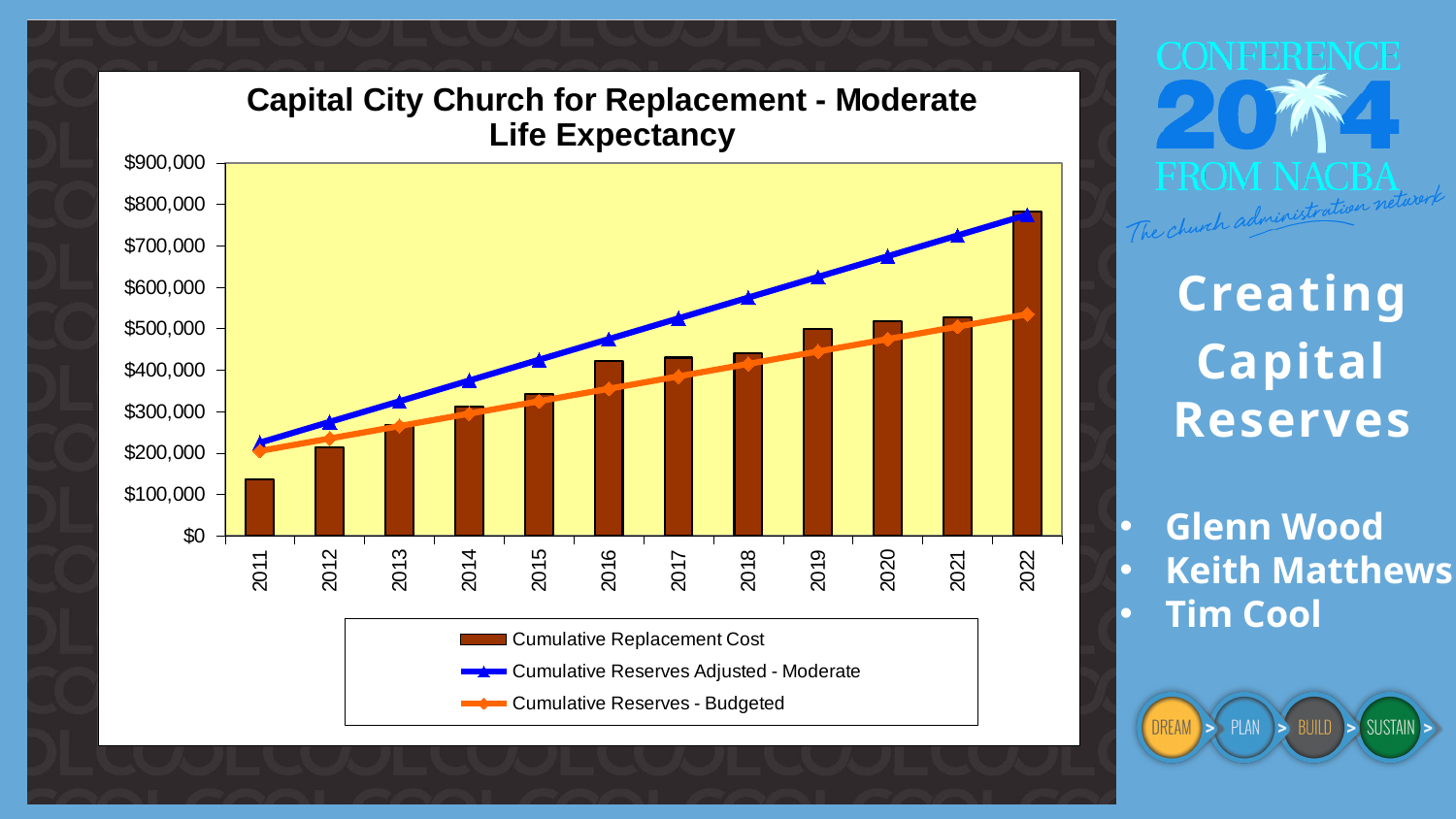
How many series does the legend list? 3 What is the title of the chart? Capital City Church for Replacement - Moderate Life Expectancy In 2022, which is higher: Cumulative Reserves Adjusted - Moderate or Cumulative Reserves - Budgeted? Cumulative Reserves Adjusted - Moderate Do the Cumulative Replacement Cost bars rise or fall from 2011 to 2022? Rise Is the Cumulative Reserves - Budgeted value for 2022 greater or less than $500,000? greater Which series is drawn as bars in the chart? Cumulative Replacement Cost Is the Cumulative Replacement Cost for 2022 greater or less than $700,000? greater Is the Cumulative Replacement Cost for 2011 greater or less than $200,000? less Which year has the lowest Cumulative Replacement Cost bar? 2011 What kind of chart is this? Combined bar and line chart How many years are shown on the x axis? 12 Which year has the highest Cumulative Replacement Cost bar? 2022